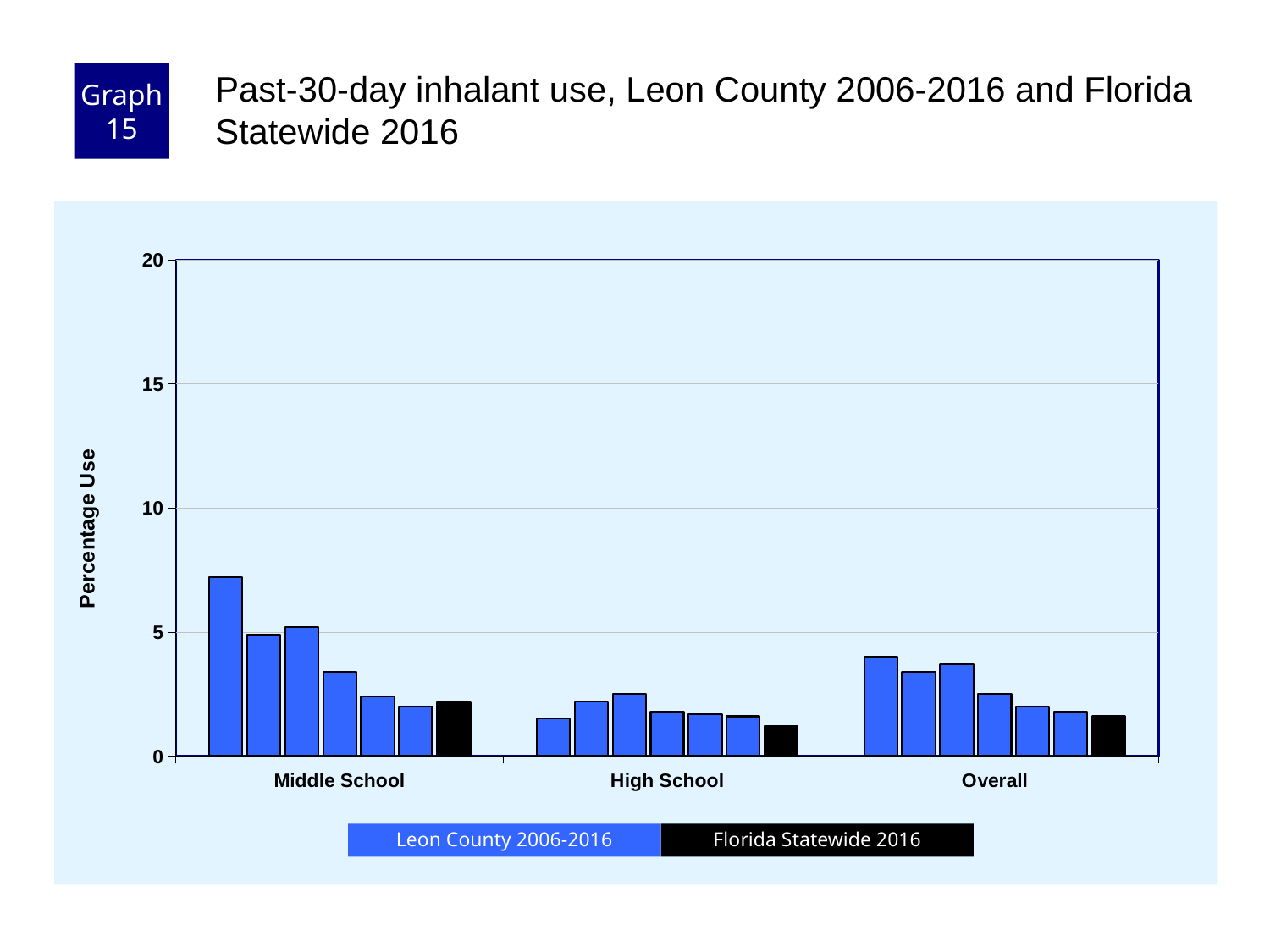
Is the Florida Statewide 2016 value for High School greater or less than 5? less Which group contains the tallest bar in the chart? Middle School How many categories are shown on the x axis of the chart? 3 How many bars are plotted in the Middle School group? 7 Which group has the lowest Florida Statewide 2016 bar? High School How many series does the chart's legend list? 2 Is the value of the tallest Leon County bar in the Middle School group greater or less than 5? greater Is the Florida Statewide 2016 value for Middle School greater or less than 5? less Do the Leon County 2006-2016 bars in the Middle School group generally rise or fall from left to right? fall Which is larger, the Florida Statewide 2016 bar for Middle School or the Florida Statewide 2016 bar for High School? Middle School What kind of chart is shown on the slide? bar chart What is the label on the chart's vertical axis? Percentage Use